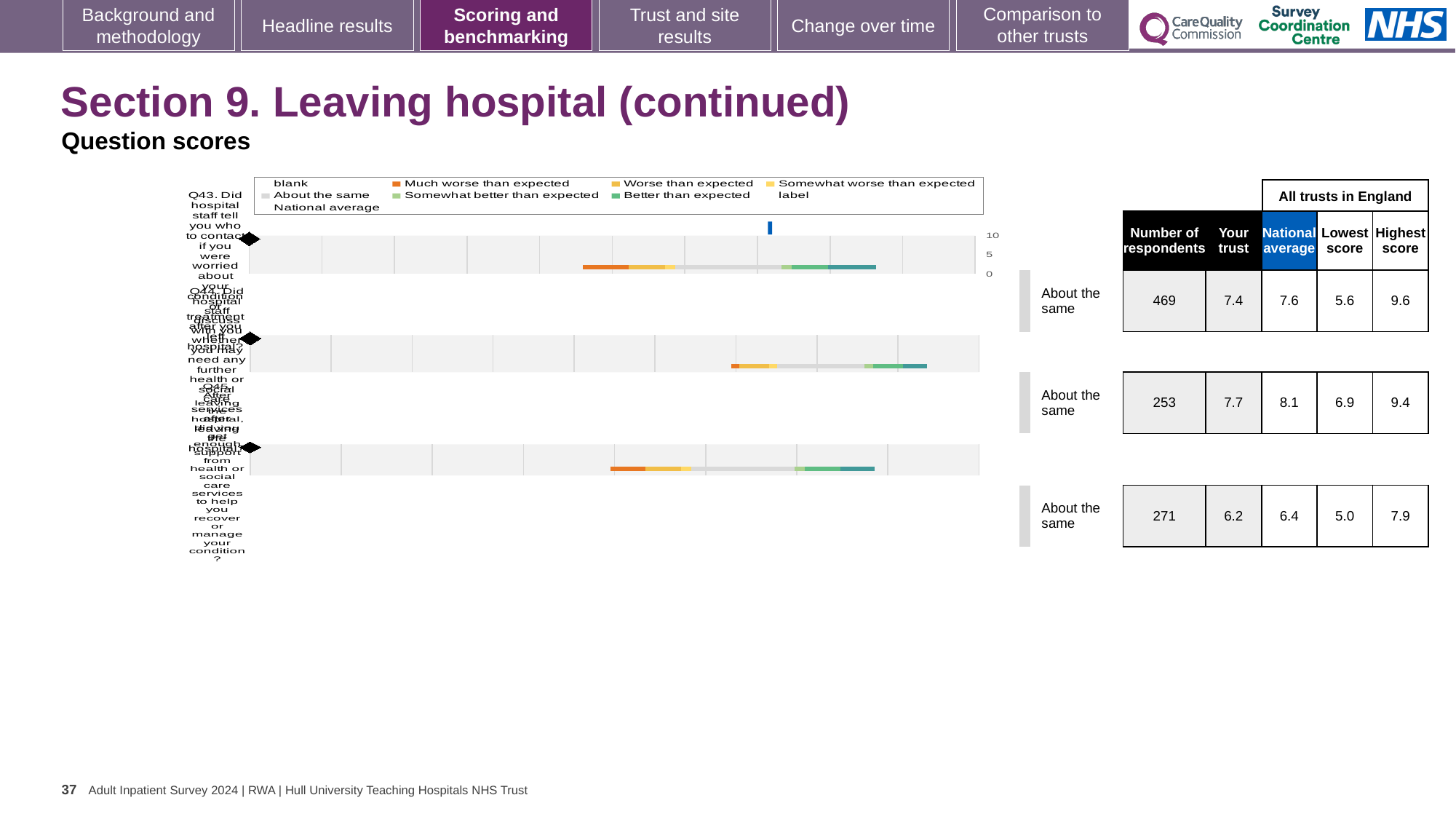
Which chart has the larger 'Your trust' score, the top chart (Q43) or the bottom chart (Q45)? the top chart (Q43) What is the 'Your trust' score for the top chart (Q43)? 7.4 What is the lowest score among all trusts in England for the bottom chart (Q45)? 5.0 How many question-score charts are shown on the slide? 3 What is the 'Your trust' score for the bottom chart (Q45)? 6.2 Which legend entry is shown in dark orange? Much worse than expected What is the national average for the middle chart (Q44)? 8.1 What is the number of respondents for the top chart (Q43)? 469 What kind of chart is used for the question scores on this slide? bar chart What is the difference between the national average and the 'Your trust' score for the middle chart (Q44)? 0.4 What is the highest score among all trusts in England for the middle chart (Q44)? 9.4 What is the highest tick value shown on the axis of the top chart? 10